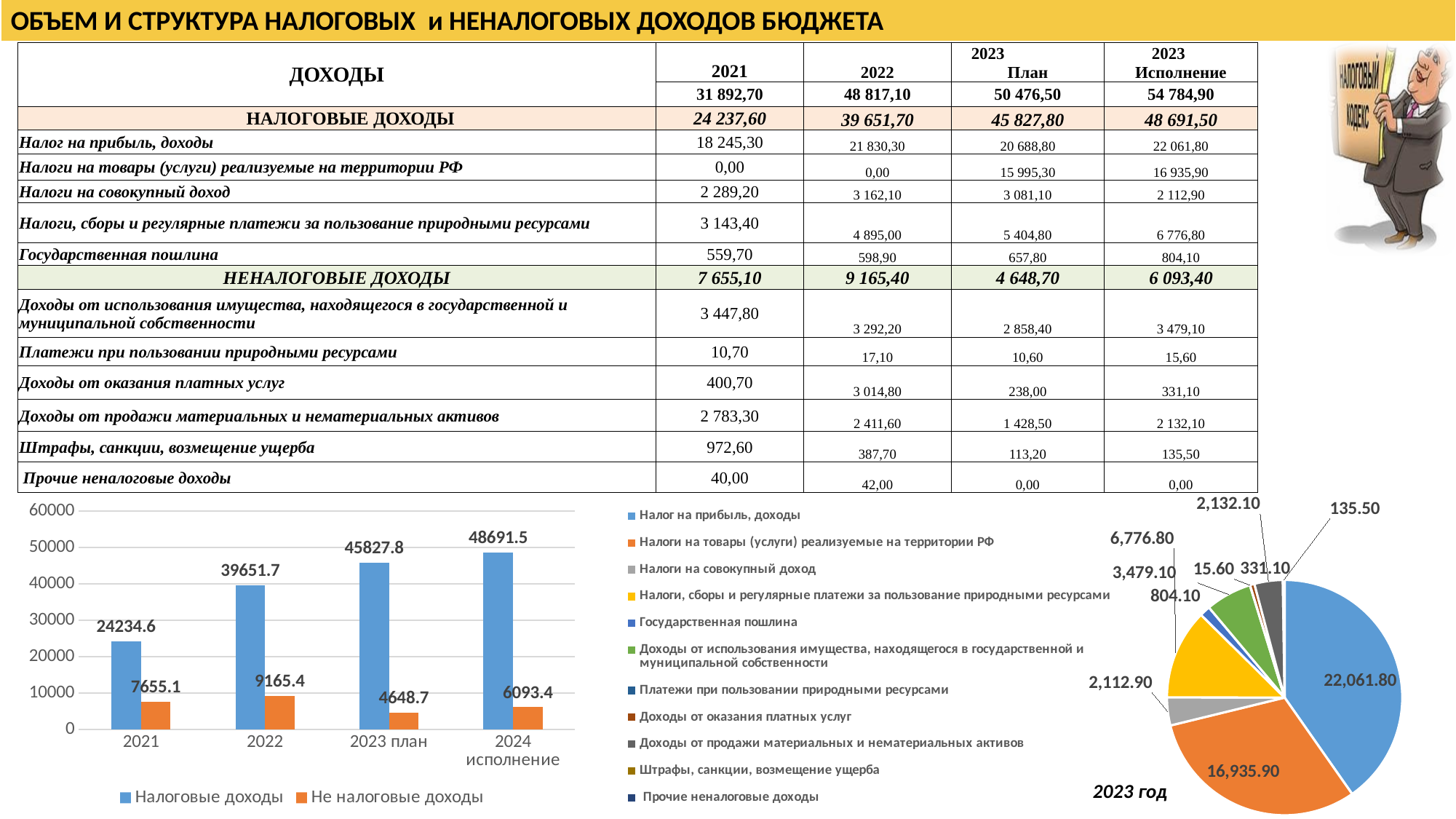
In the bar chart at the bottom left, which category has the highest value for Налоговые доходы? 2024 исполнение In the bar chart at the bottom left, what is the difference between Налоговые доходы for 2024 исполнение and for 2023 план? 2863.7 In the bar chart at the bottom left, which category has the lowest value for Не налоговые доходы? 2023 план In the bar chart at the bottom left, what is the value of Налоговые доходы for 2022? 39651.7 In the bar chart at the bottom left, which is larger: Не налоговые доходы for 2021 or for 2022? 2022 What kind of chart is the chart at the bottom left of the slide? bar chart How many series does the legend of the bar chart at the bottom left list? 2 In the bar chart at the bottom left, what is the value of Не налоговые доходы for 2023 план? 4648.7 How many categories are shown on the x axis of the bar chart at the bottom left? 4 In the pie chart labelled 2023 год, which category has the largest slice? Налог на прибыль, доходы In the pie chart labelled 2023 год, what is the value of the slice for Налог на прибыль, доходы? 22,061.80 In the bar chart at the bottom left, do the values for Налоговые доходы rise or fall from 2021 to 2024 исполнение? rise